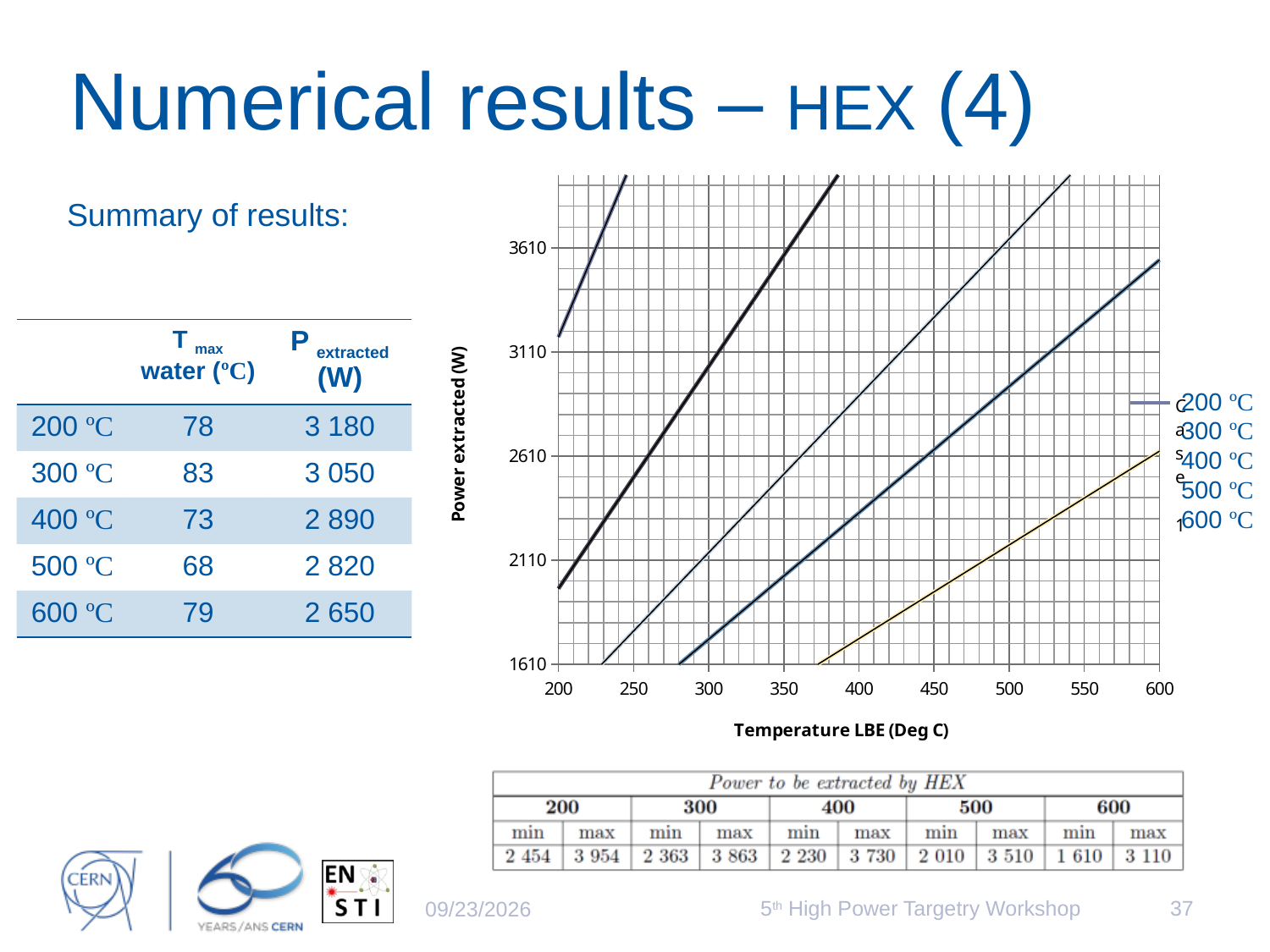
What is the title of the chart's x axis? Temperature LBE (Deg C) What kind of chart is shown on the slide? line chart Is the value of the highest plotted line at a temperature of 250 greater or less than 3110? greater What is the title of the chart's y axis? Power extracted (W) How many series does the chart's legend list? 5 Do the plotted lines rise or fall as Temperature LBE increases along the x axis? rise Is the value of the lowest plotted line at a temperature of 400 greater or less than 2110? less Is the value of the lowest plotted line at a temperature of 600 greater or less than 2110? greater